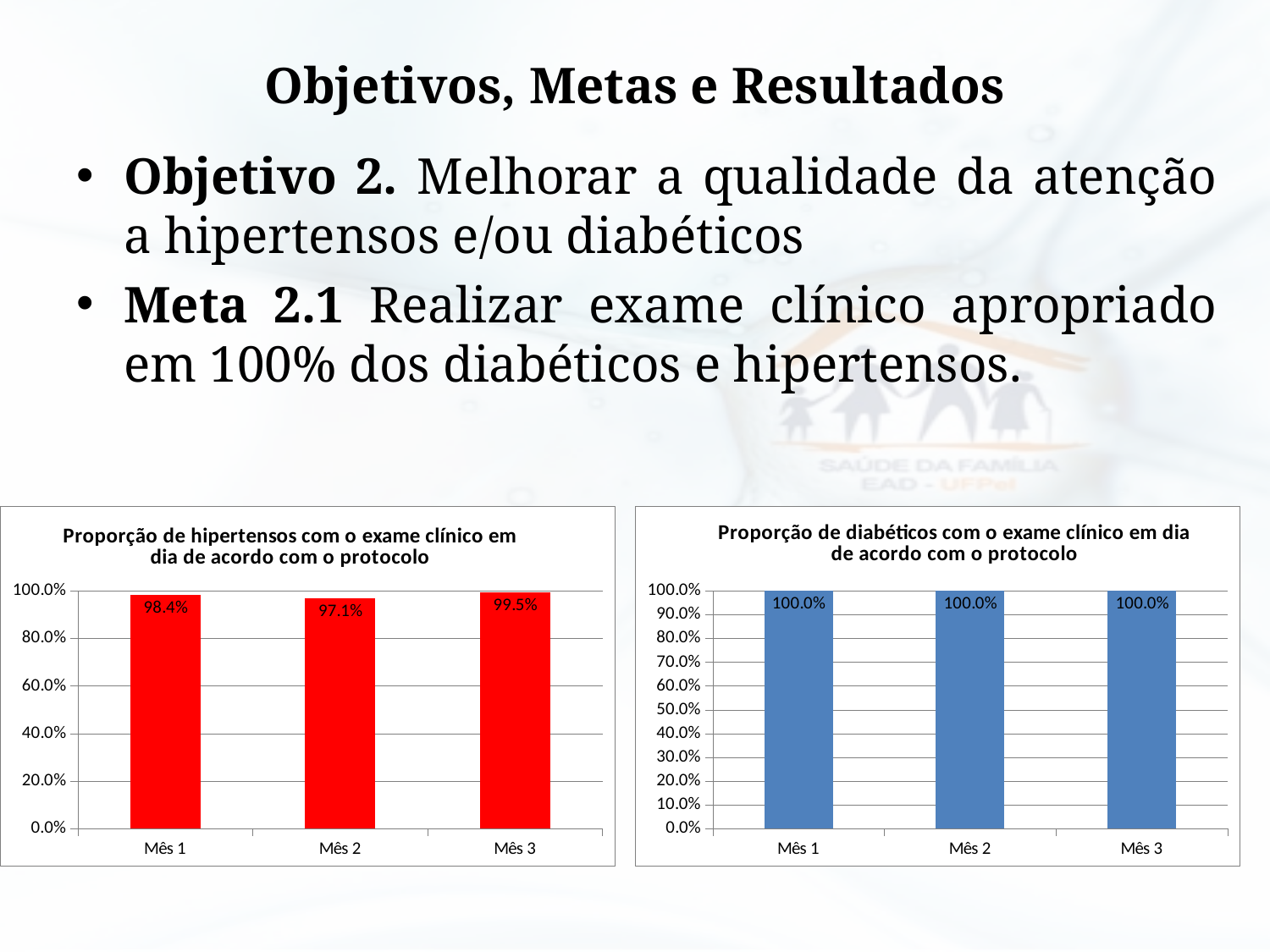
In the chart 'Proporção de diabéticos com o exame clínico em dia de acordo com o protocolo', do the values rise, fall or stay the same across the months? stay the same In the chart 'Proporção de hipertensos com o exame clínico em dia de acordo com o protocolo', what is the value for Mês 2? 97.1% What kind of chart is the chart on the left of the slide? bar chart In the chart 'Proporção de hipertensos com o exame clínico em dia de acordo com o protocolo', what is the difference between the values for Mês 3 and Mês 2? 2.4% In the chart 'Proporção de hipertensos com o exame clínico em dia de acordo com o protocolo', which month has the lowest value? Mês 2 In the chart 'Proporção de hipertensos com o exame clínico em dia de acordo com o protocolo', which month has the highest value? Mês 3 In the chart 'Proporção de diabéticos com o exame clínico em dia de acordo com o protocolo', how many months are shown on the x axis? 3 What colour are the bars in the chart 'Proporção de diabéticos com o exame clínico em dia de acordo com o protocolo'? blue In the chart 'Proporção de hipertensos com o exame clínico em dia de acordo com o protocolo', which is larger, the value for Mês 1 or Mês 2? Mês 1 In the chart 'Proporção de hipertensos com o exame clínico em dia de acordo com o protocolo', what is the value for Mês 3? 99.5% In the chart 'Proporção de hipertensos com o exame clínico em dia de acordo com o protocolo', what is the value for Mês 1? 98.4% In the chart 'Proporção de diabéticos com o exame clínico em dia de acordo com o protocolo', what is the value for Mês 2? 100.0%